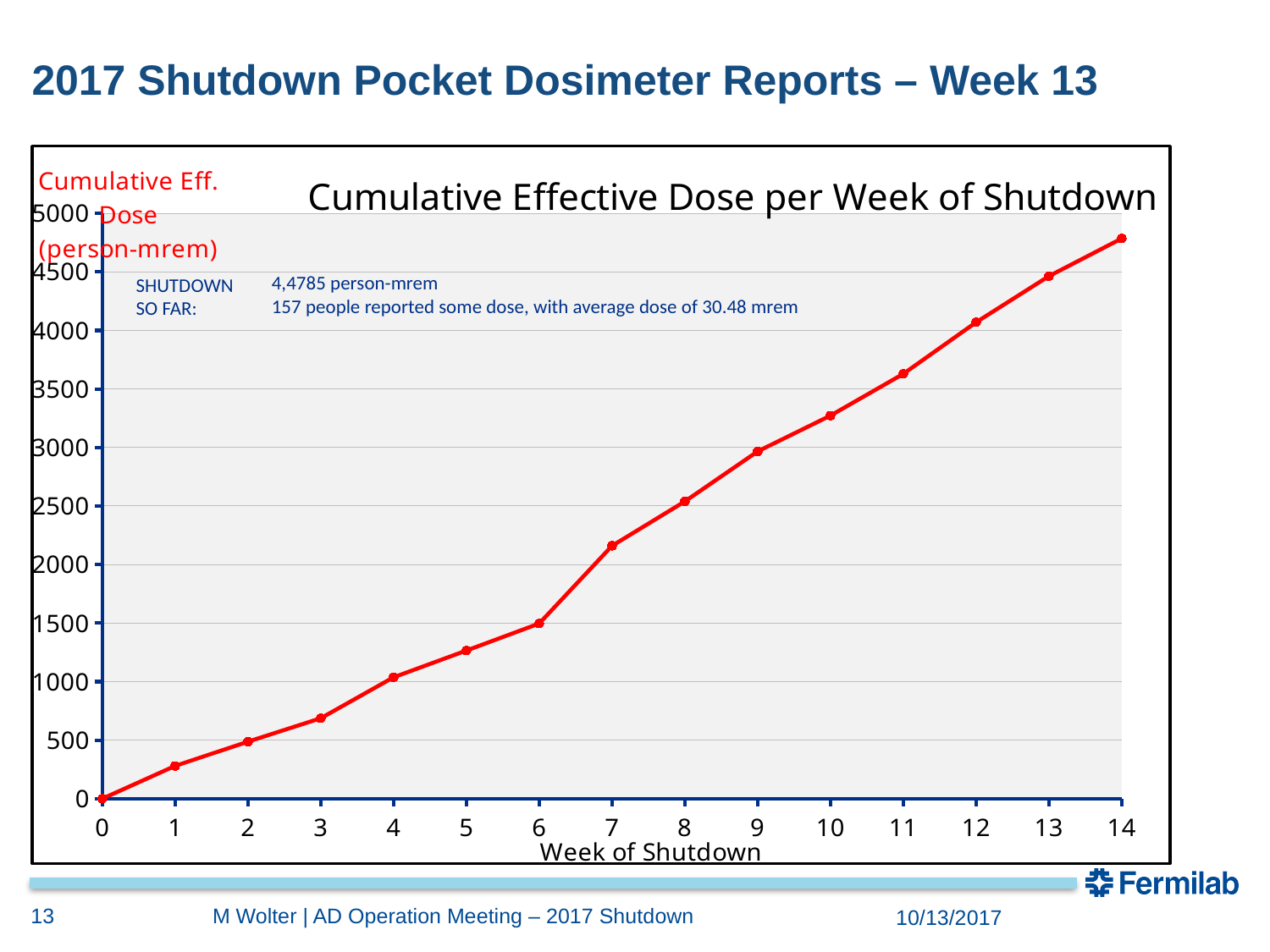
What is the label of the x axis? Week of Shutdown Which week has the larger cumulative effective dose, week 4 or week 10? week 10 What is the title of the chart? Cumulative Effective Dose per Week of Shutdown At which week is the cumulative effective dose lowest? 0 Is the value for week 5 greater or less than 1500? less What is the cumulative effective dose at week 0? 0 At which week is the cumulative effective dose highest? 14 Is the value for week 7 greater or less than 2000? greater How many data points are plotted on the line? 15 What kind of chart is shown on the slide? line chart Do the values rise or fall as the week of shutdown increases? rise